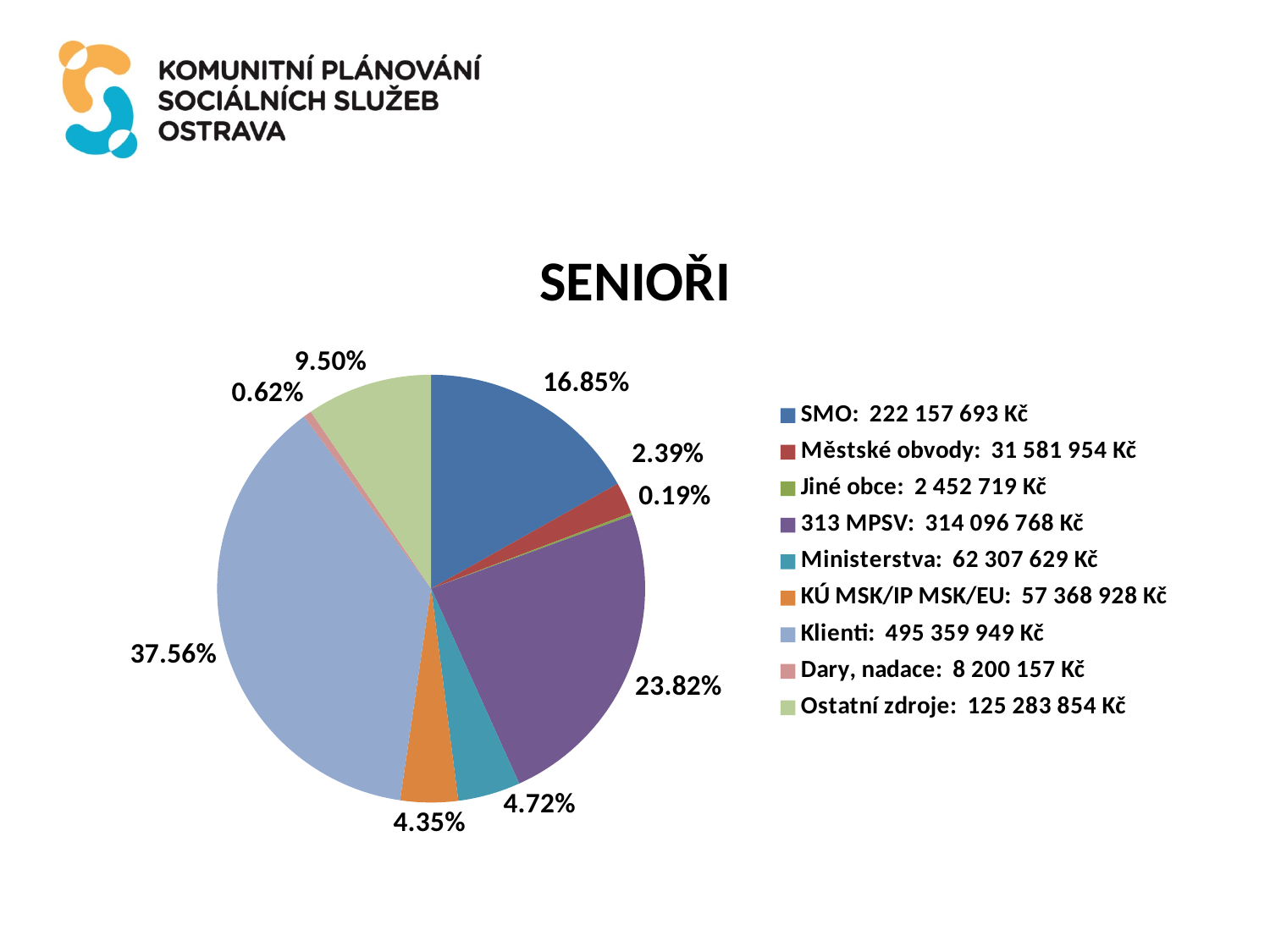
What value is shown in the legend for Ministerstva? 62 307 629 Kč Which category has the largest share of the pie? Klienti How many slices does the pie chart have? 9 What type of chart is shown on the slide? pie chart What is the difference in percentage points between the shares of Klienti and 313 MPSV? 13.74 What is the title of the chart? SENIOŘI Which has a larger share of the pie, Ministerstva or KÚ MSK/IP MSK/EU? Ministerstva What share of the pie does 313 MPSV represent? 23.82% Which category has the smallest share of the pie? Jiné obce What share of the pie does Klienti represent? 37.56% What share of the pie does SMO represent? 16.85% What value is shown in the legend for Ostatní zdroje? 125 283 854 Kč